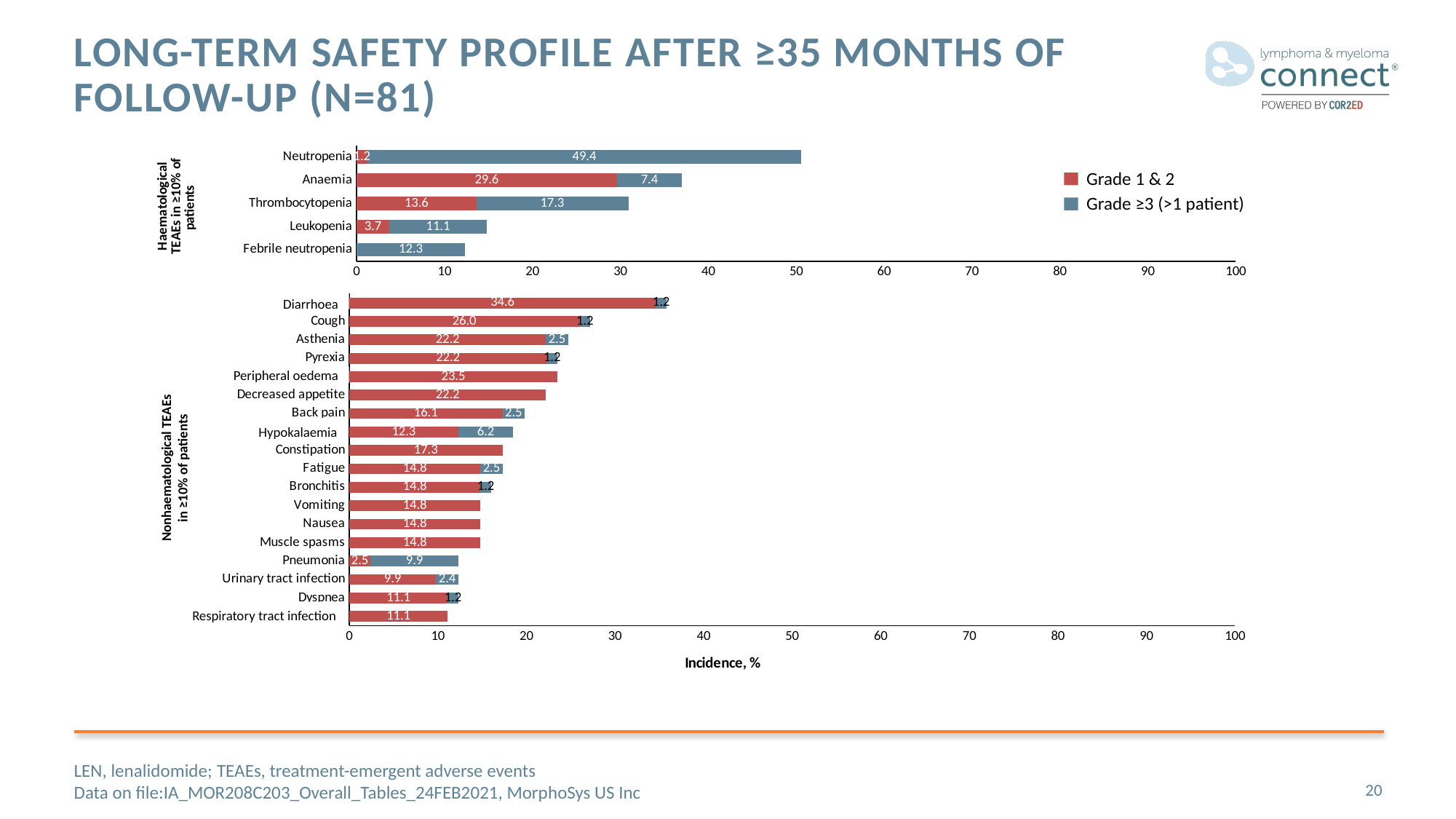
In the top chart (Haematological TEAEs), what is the Grade ≥3 incidence for Neutropenia? 49.4 How many categories are plotted in the bottom chart (Nonhaematological TEAEs)? 18 In the top chart (Haematological TEAEs), which category has the highest Grade ≥3 incidence? Neutropenia In the top chart (Haematological TEAEs), what is the Grade 1 & 2 incidence for Anaemia? 29.6 In the top chart (Haematological TEAEs), what is the total incidence (Grade 1 & 2 plus Grade ≥3) for Thrombocytopenia? 30.9 In the bottom chart (Nonhaematological TEAEs), what is the Grade ≥3 incidence for Hypokalaemia? 6.2 In the bottom chart (Nonhaematological TEAEs), which is larger: the Grade 1 & 2 incidence for Cough or for Constipation? Cough What kind of chart is used on this slide? Stacked bar chart In the bottom chart (Nonhaematological TEAEs), what is the Grade 1 & 2 incidence for Diarrhoea? 34.6 How many series does the legend list? 2 What is the x-axis label shown below the bottom chart? Incidence, % In the top chart (Haematological TEAEs), what is the difference between the Grade 1 & 2 and Grade ≥3 incidence for Anaemia? 22.2